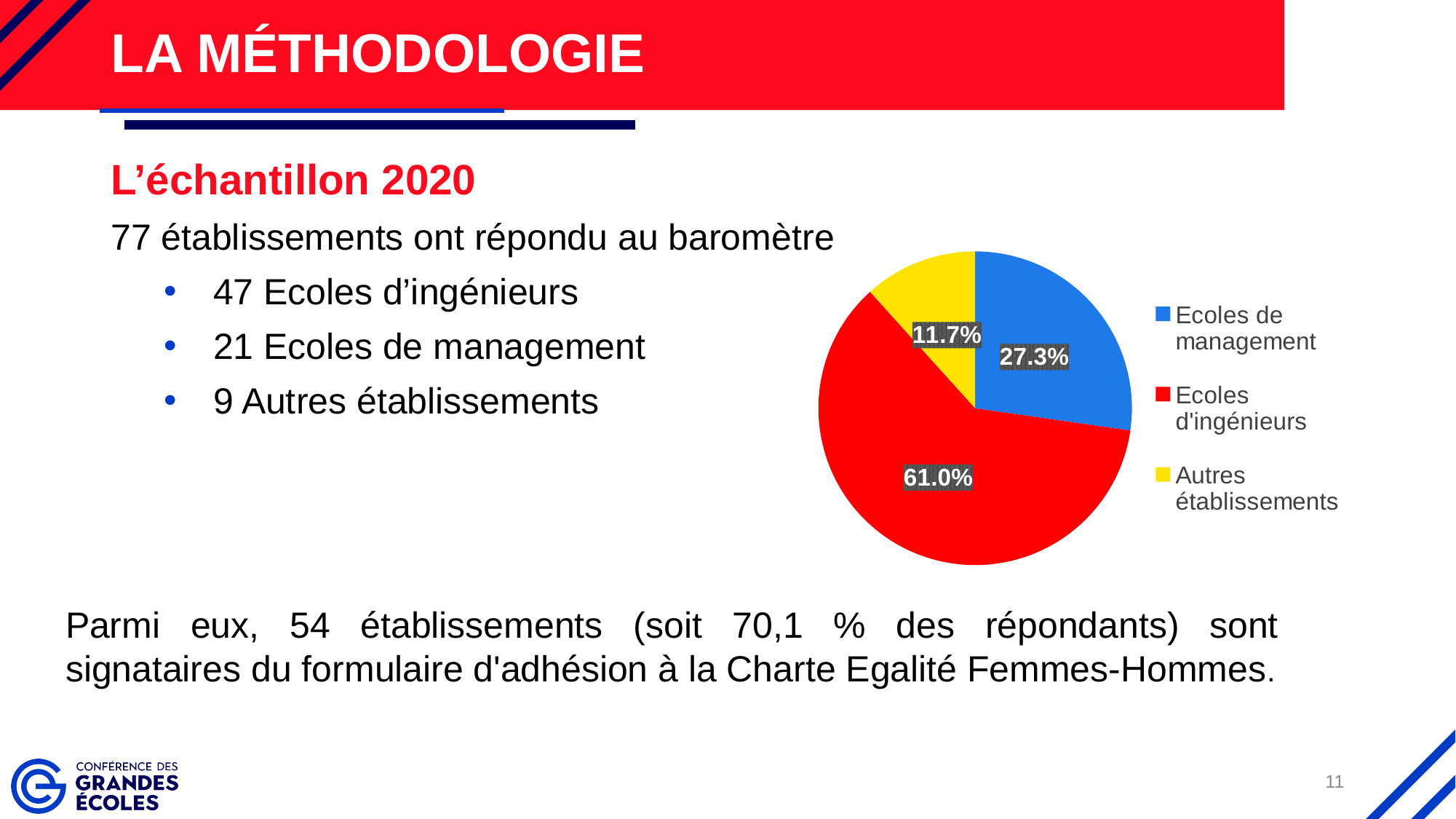
What share of the pie does Ecoles d'ingénieurs represent? 61.0% Which is larger, the slice for Ecoles de management or the slice for Autres établissements? Ecoles de management What kind of chart is shown on the slide? pie chart Which category has the largest slice of the pie? Ecoles d'ingénieurs What is the difference in percentage points between Ecoles d'ingénieurs and Ecoles de management? 33.7 What is the difference in percentage points between Ecoles de management and Autres établissements? 15.6 What colour is the slice for Ecoles d'ingénieurs? red What share of the pie does Autres établissements represent? 11.7% What share of the pie does Ecoles de management represent? 27.3% How many categories does the pie chart show? 3 Which category has the smallest slice of the pie? Autres établissements What colour is the slice for Autres établissements? yellow